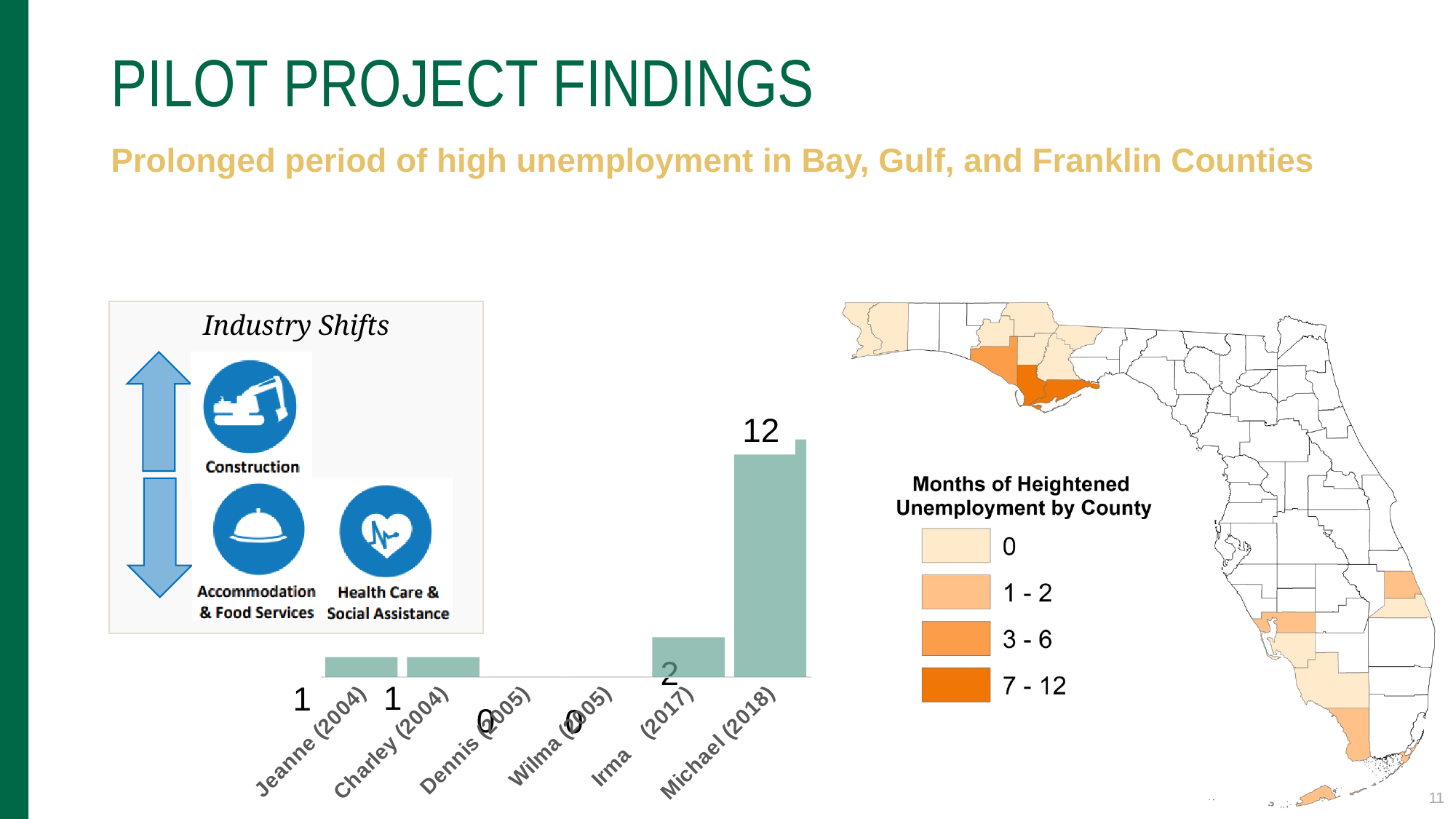
What is the highest range shown in the legend of the map 'Months of Heightened Unemployment by County'? 7 - 12 What value is shown for Jeanne (2004) in the bar chart? 1 How many categories does the legend of the map 'Months of Heightened Unemployment by County' list? 4 How many hurricanes are shown in the bar chart? 6 Which hurricanes have the lowest value in the bar chart? Dennis (2005) and Wilma (2005) What value is shown for Irma (2017) in the bar chart? 2 What value is shown for Dennis (2005) in the bar chart? 0 What value is shown for Michael (2018) in the bar chart? 12 What kind of chart is used to show the values for the hurricanes? Bar chart Which has the larger value in the bar chart, Irma (2017) or Charley (2004)? Irma (2017) What is the difference between the values for Michael (2018) and Irma (2017) in the bar chart? 10 Which hurricane has the highest value in the bar chart? Michael (2018)